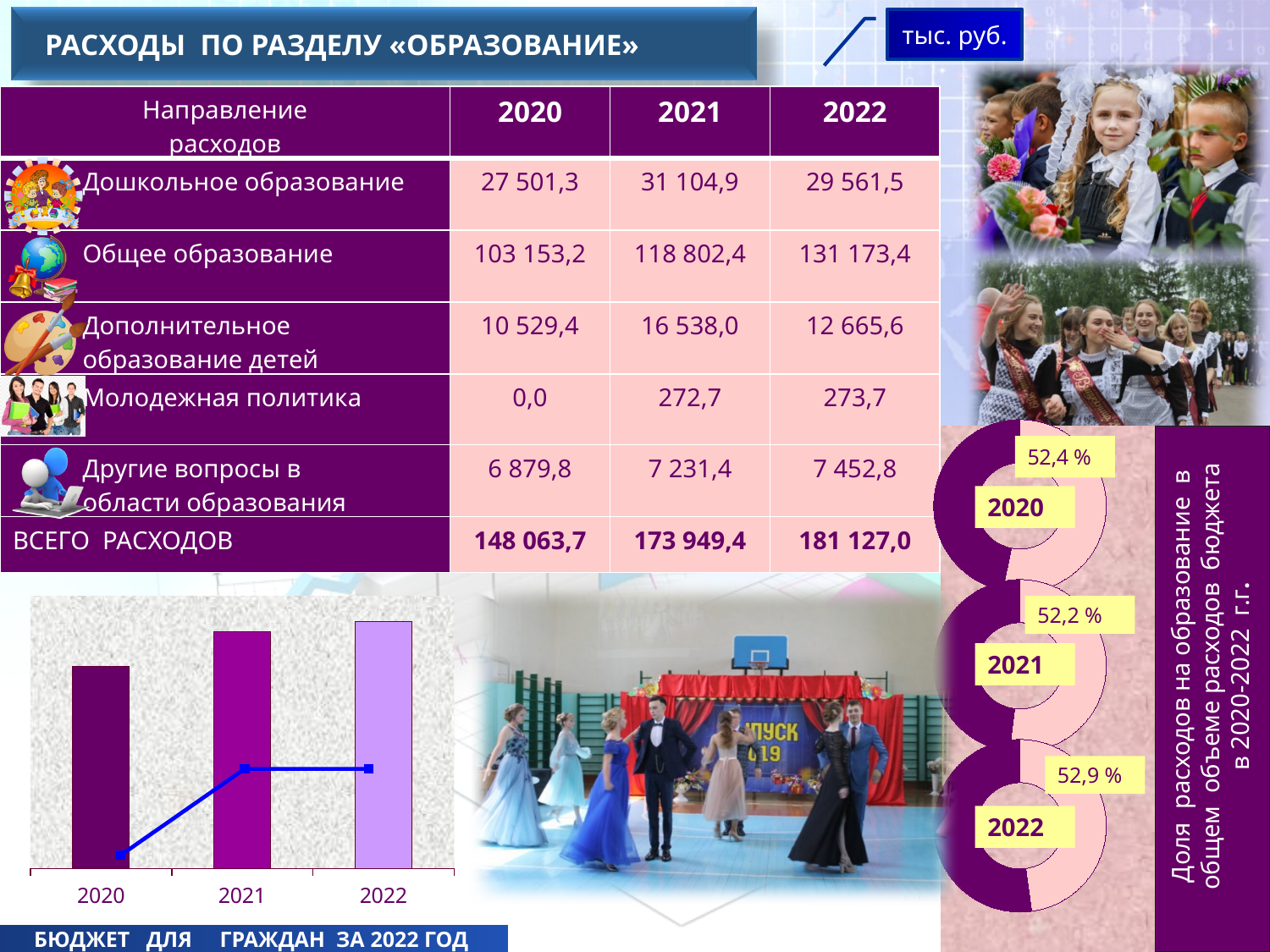
In the bar chart at the bottom left, is the bar for 2021 taller or shorter than the bar for 2020? taller In the donut charts on the right, what share is shown for 2022? 52,9 % In the bar chart at the bottom left, which year has the tallest bar? 2022 What kind of chart is shown at the bottom left of the slide? bar chart In the donut charts on the right, by how many percentage points does the 2022 share exceed the 2021 share? 0,7 % In the bar chart at the bottom left, which year has the shortest bar? 2020 In the donut charts on the right (share of education spending in total budget spending), what share is shown for 2020? 52,4 % Among the donut charts on the right, which year has the lowest share of education spending? 2021 How many years are shown on the x axis of the bar chart at the bottom left? 3 In the donut charts on the right, what share is shown for 2021? 52,2 % Among the donut charts on the right, which year has the highest share of education spending? 2022 In the bar chart at the bottom left, do the bars rise or fall from 2020 to 2022? rise